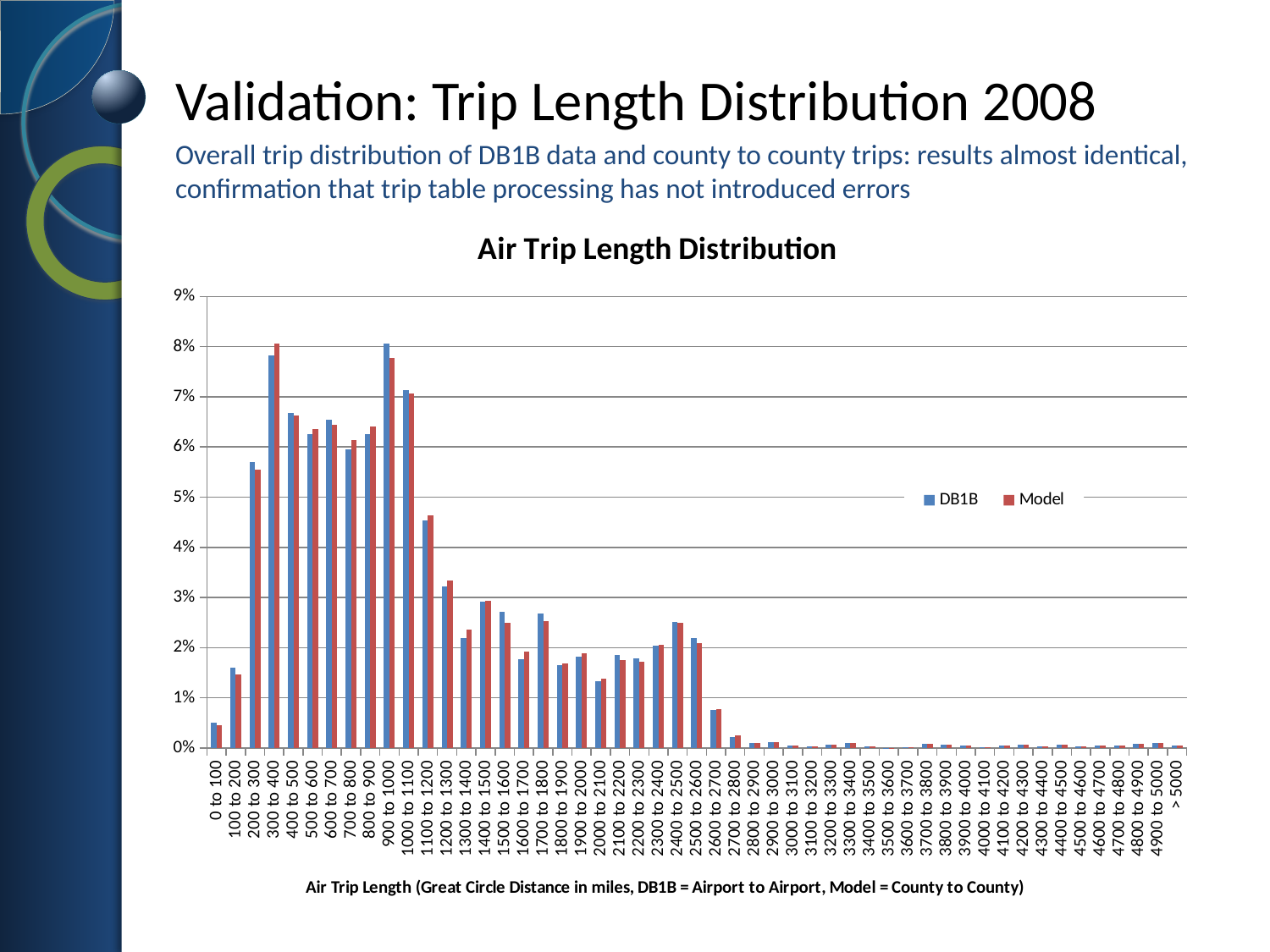
Which trip length category has the highest Model value? 300 to 400 How many series does the chart legend list? 2 Is the DB1B value for 0 to 100 greater or less than 1%? less Which trip length category has the highest DB1B value? 900 to 1000 What type of chart is shown on the slide? Bar chart Is the DB1B value for 1100 to 1200 greater or less than 5%? less For the 200 to 300 category, which series has the larger value, DB1B or Model? DB1B For the 1300 to 1400 category, which series has the larger value, DB1B or Model? Model Is the Model value for 1200 to 1300 greater or less than 3%? greater What is the title of the chart? Air Trip Length Distribution Which series is shown in red in the chart? Model